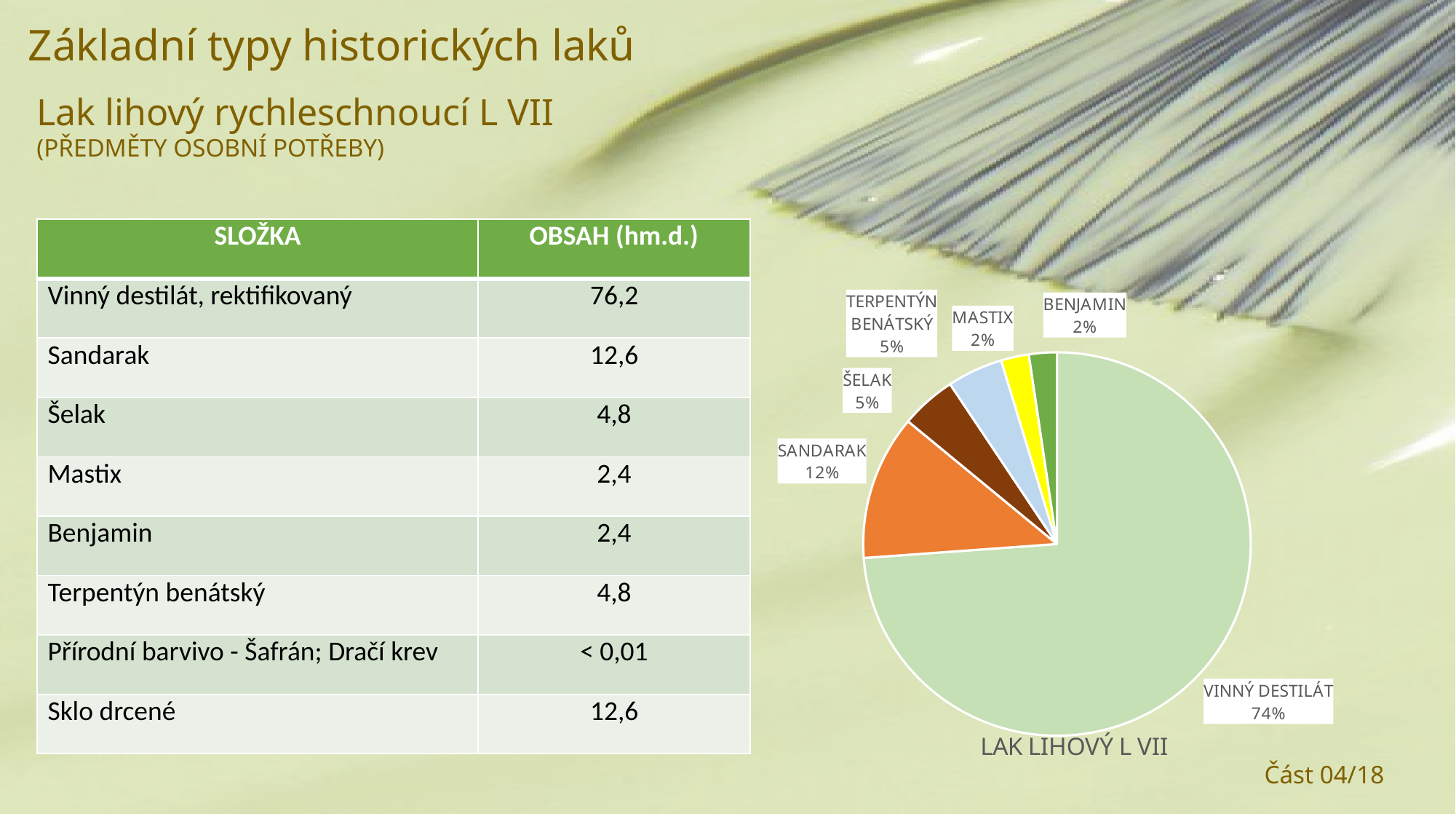
What share of the pie chart does MASTIX have? 2% What colour is the SANDARAK slice in the pie chart? orange What share of the pie chart does BENJAMIN have? 2% What share of the pie chart does VINNÝ DESTILÁT have? 74% What kind of chart is shown on the slide? pie chart Which is larger in the pie chart, SANDARAK or ŠELAK? SANDARAK How many slices does the pie chart have? 6 Which slice of the pie chart is the largest? VINNÝ DESTILÁT What is the title of the pie chart? LAK LIHOVÝ L VII What is the difference in percentage points between the VINNÝ DESTILÁT slice and the SANDARAK slice? 62